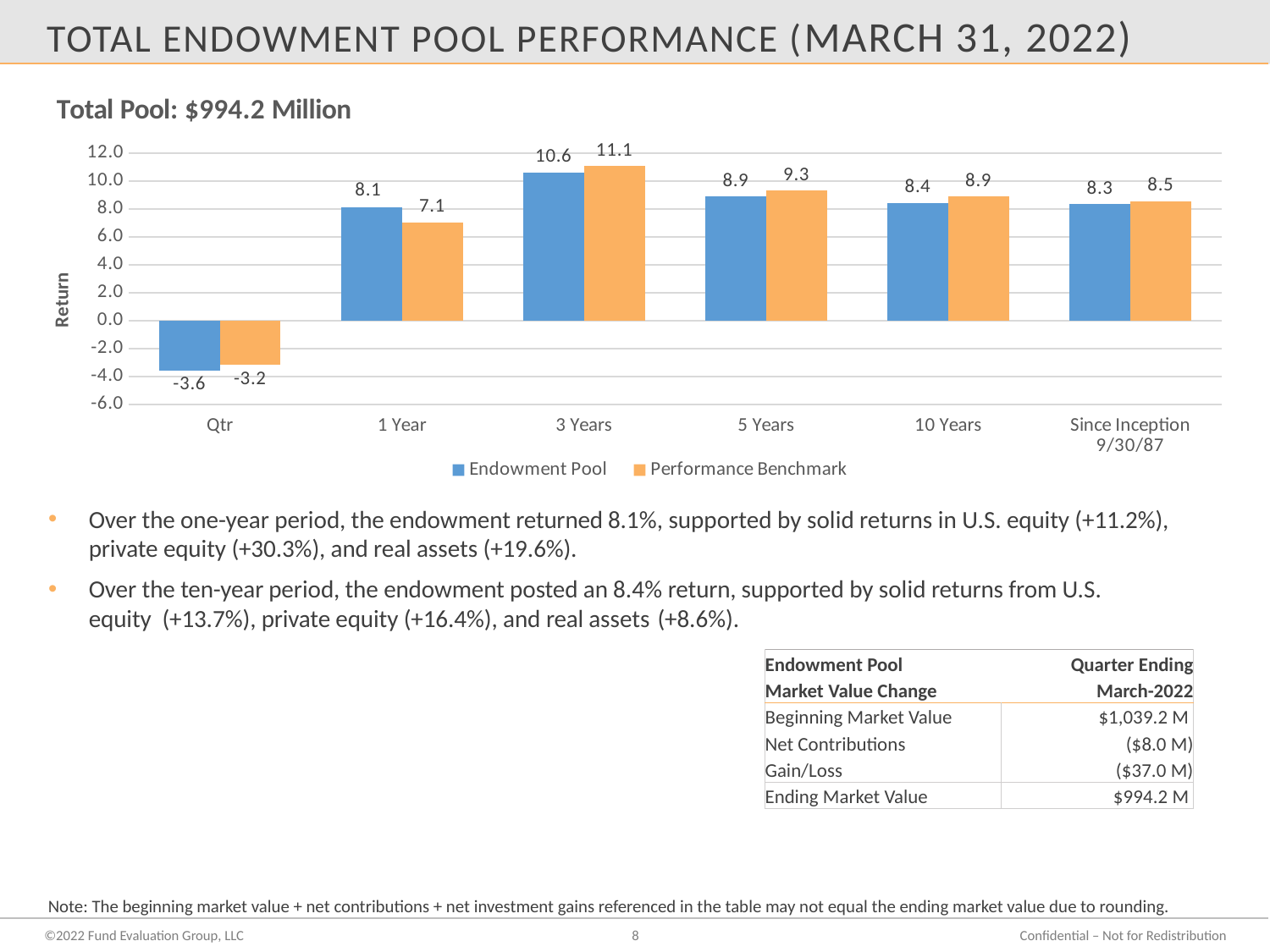
What is the Performance Benchmark return for the Since Inception 9/30/87 period? 8.5 How many time periods are shown on the x axis of the chart? 6 How many series does the chart legend list? 2 Is the Endowment Pool return for the 5 Years period greater or less than 10.0? less What kind of chart is shown on the slide? Bar chart Which period has the lowest Performance Benchmark return? Qtr What is the Endowment Pool return for the 1 Year period? 8.1 What is the difference between the Performance Benchmark and Endowment Pool returns for the 1 Year period? 1.0 Which period has the highest Endowment Pool return? 3 Years What is the Performance Benchmark return for the 3 Years period? 11.1 For the 10 Years period, which is larger: the Endowment Pool return or the Performance Benchmark return? Performance Benchmark What is the Endowment Pool return for the Qtr period? -3.6